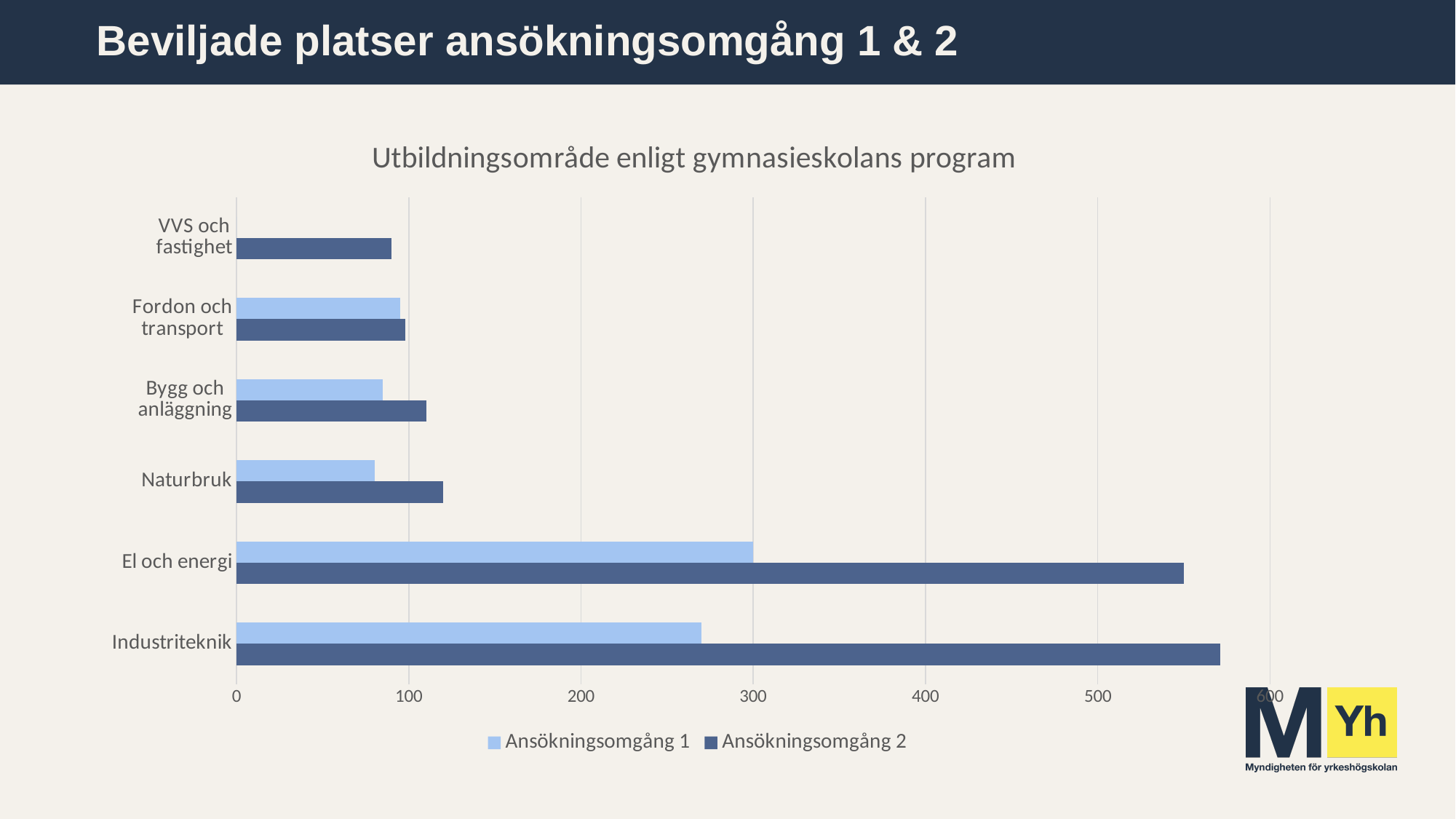
Is the value for Naturbruk in Ansökningsomgång 2 greater or less than 100? greater Is the value for Naturbruk in Ansökningsomgång 1 greater or less than 100? less Is the value for Industriteknik in Ansökningsomgång 1 greater or less than 300? less What kind of chart is shown on the slide? Bar chart For Naturbruk, which series has the larger value, Ansökningsomgång 1 or Ansökningsomgång 2? Ansökningsomgång 2 How many series does the legend list? 2 How many categories are shown on the chart? 6 Which category has the highest value for Ansökningsomgång 2? Industriteknik Which category shows a bar only for Ansökningsomgång 2 and none for Ansökningsomgång 1? VVS och fastighet Which category has the highest value for Ansökningsomgång 1? El och energi What is the title of the chart? Utbildningsområde enligt gymnasieskolans program